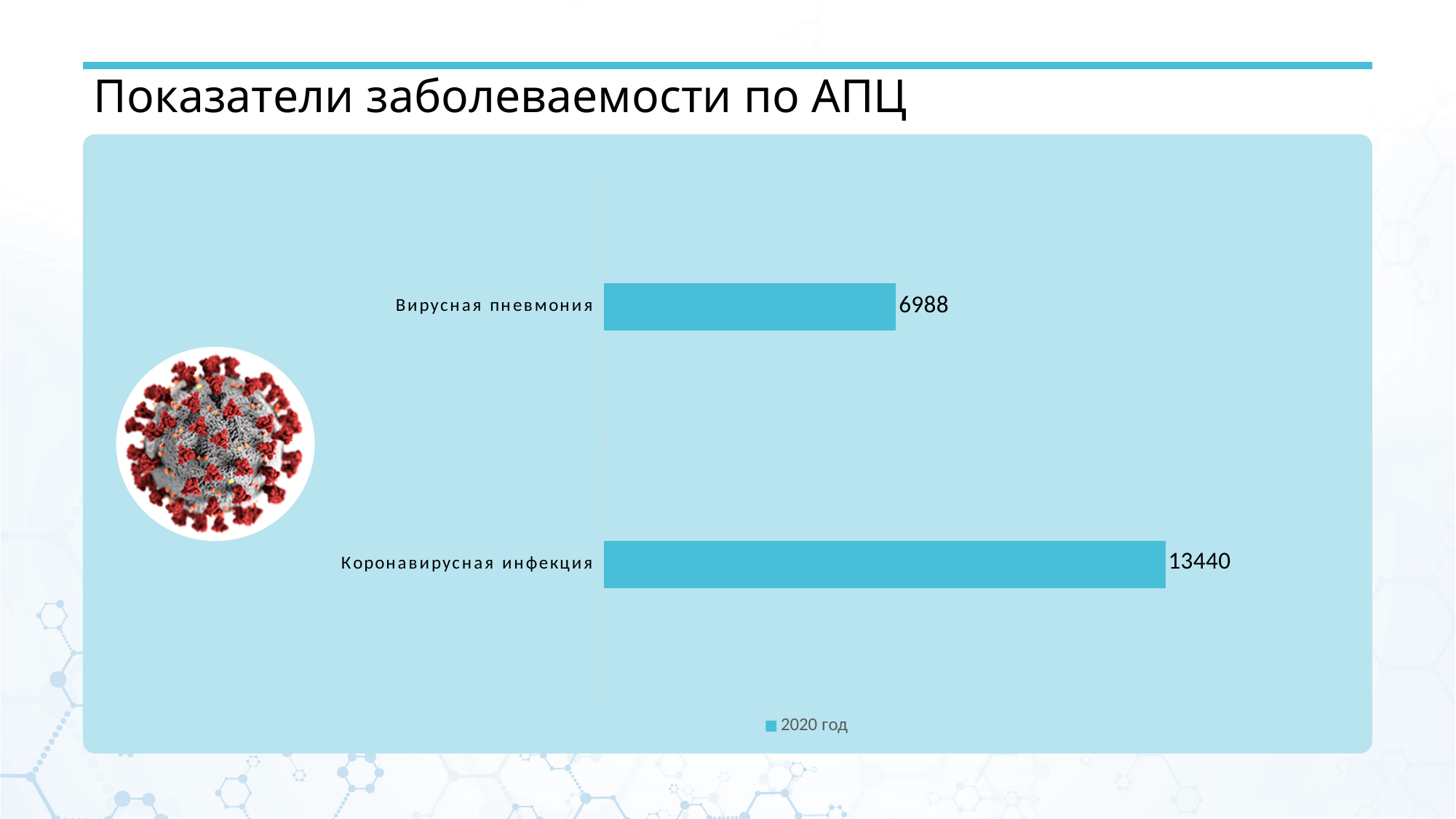
What is the difference between the values for Коронавирусная инфекция and Вирусная пневмония? 6452 Which is larger, the value for Вирусная пневмония or the value for Коронавирусная инфекция? Коронавирусная инфекция Which category has the highest value? Коронавирусная инфекция What series name is shown in the legend? 2020 год What kind of chart is shown on the slide? Bar chart Which category has the lowest value? Вирусная пневмония How many categories are shown in the chart? 2 What is the value for Вирусная пневмония? 6988 What is the title of the slide? Показатели заболеваемости по АПЦ How many series does the legend list? 1 What is the total of the two values shown in the chart? 20428 What is the value for Коронавирусная инфекция? 13440